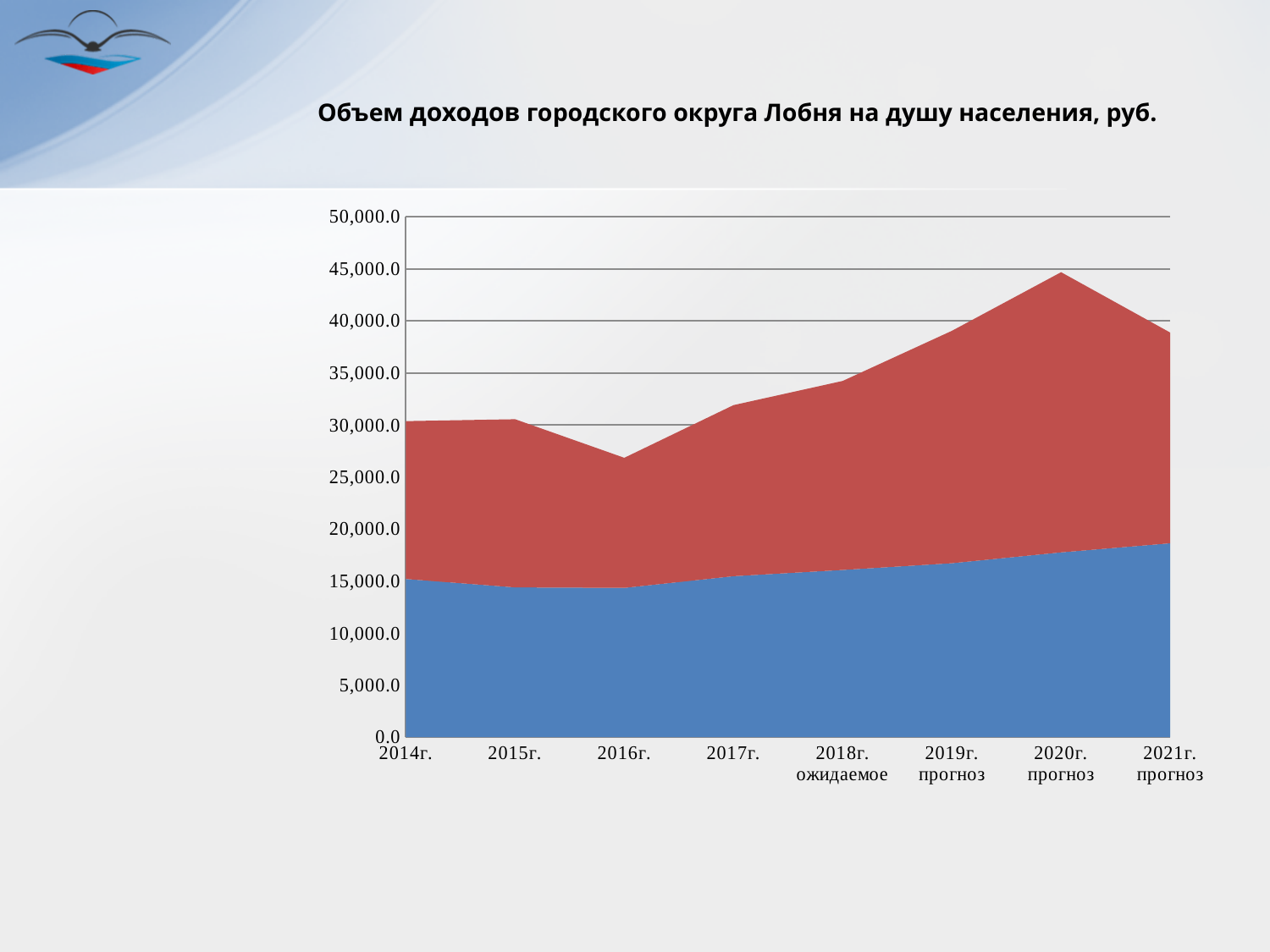
What kind of chart is shown on the slide? Stacked area chart Which year has the larger total: 2020г. прогноз or 2021г. прогноз? 2020г. прогноз In which year does the total (top of the red area) reach its highest value? 2020г. прогноз Is the total value for 2016г. greater or less than 30,000.0? less What is the title of the chart? Объем доходов городского округа Лобня на душу населения, руб. Does the total value rise or fall from 2016г. to 2020г. прогноз? rise In which year is the total (top of the red area) lowest? 2016г. Is the blue series value for 2021г. прогноз greater or less than 20,000.0? less Is the total value for 2020г. прогноз greater or less than 40,000.0? greater How many years (categories) are shown along the x axis? 8 In which year is the blue (bottom) series highest? 2021г. прогноз How many series (coloured areas) are stacked in the chart? 2